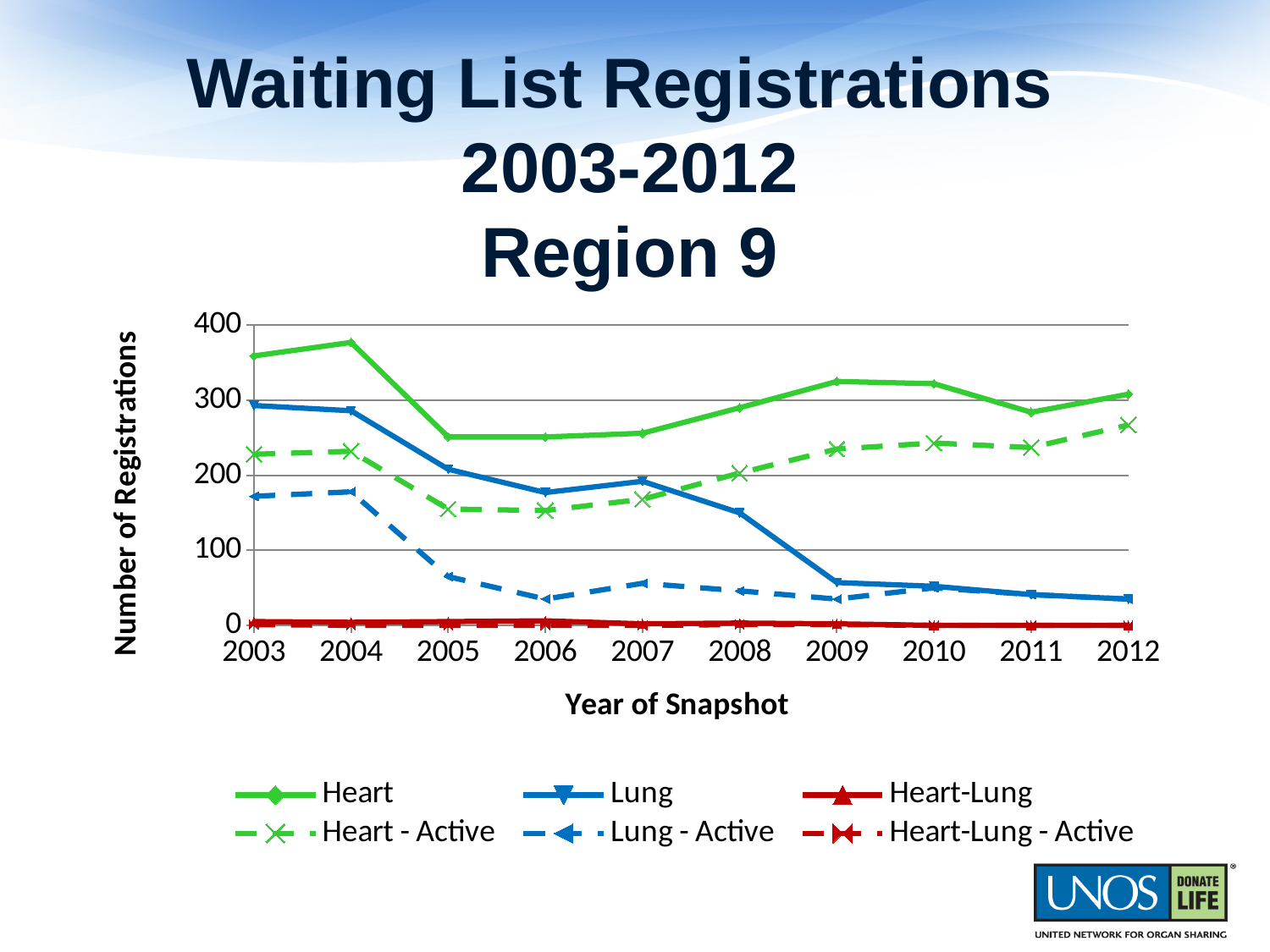
Is the Lung value for 2012 greater or less than 100? less In which year does the Heart series reach its highest value? 2004 Is the Heart - Active value for 2012 greater or less than 200? greater What kind of chart is shown on the slide? line chart What is the title of the y axis? Number of Registrations How many years are plotted along the x axis? 10 In 2012, which is larger, the Heart value or the Lung value? Heart Which is larger, the Lung - Active value in 2003 or in 2009? 2003 Does the Lung series rise or fall from 2003 to 2012? fall Is the Heart value for 2004 greater or less than 300? greater How many series does the legend list? 6